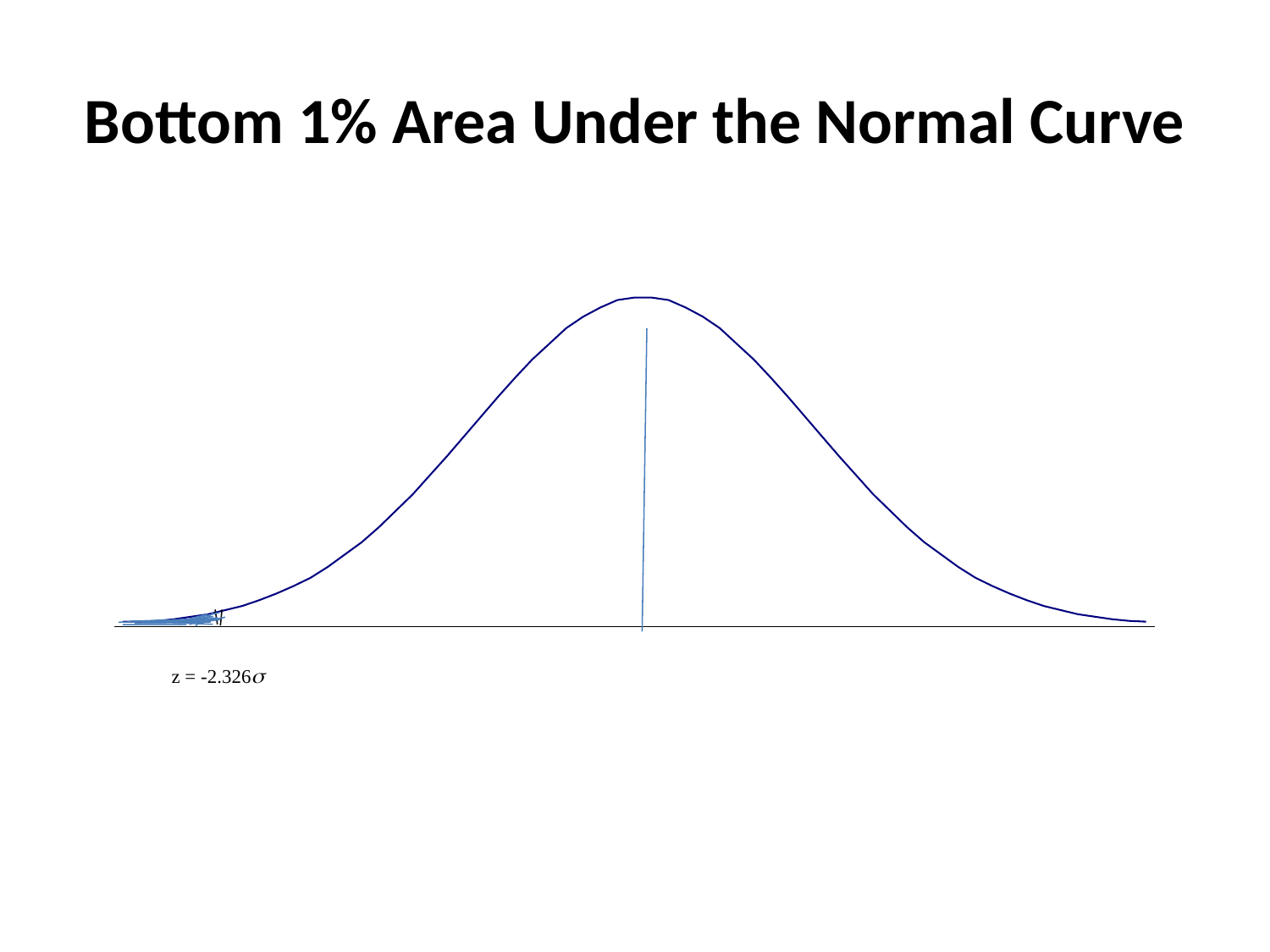
Which tail of the curve is shaded, left or right? left Does the curve rise or fall moving from the centre toward the right edge? fall According to the title, what percentage of the area under the curve is shaded? 1% What kind of chart is shown on the slide? line chart What z value is labelled below the left tail of the curve? z = -2.326σ Does the curve rise or fall moving from the left edge toward the centre? rise What is the title of the chart on the slide? Bottom 1% Area Under the Normal Curve Is the shaded region to the left or to the right of the vertical line at the centre of the curve? left